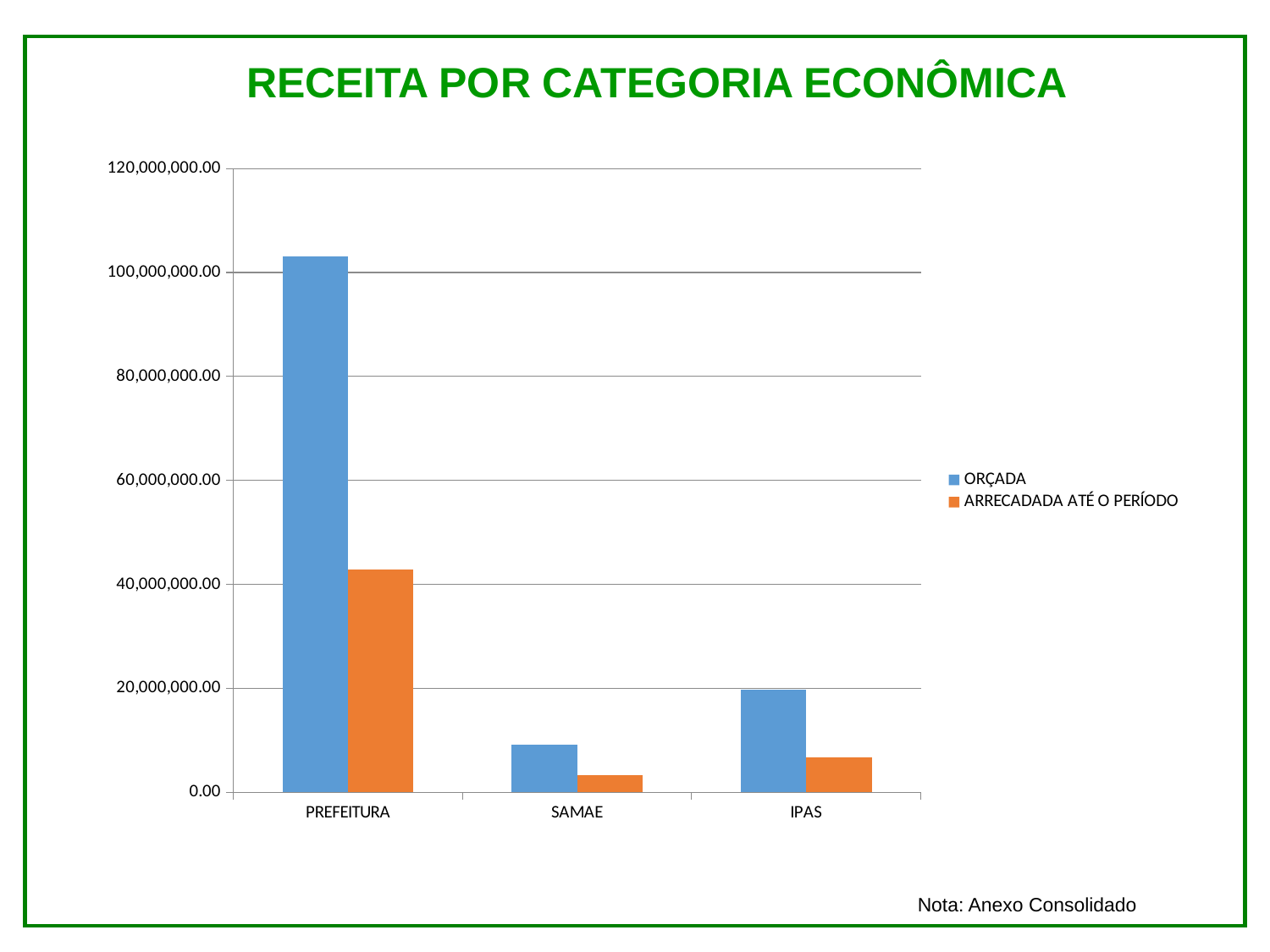
Is the ORÇADA value for PREFEITURA greater or less than 80,000,000.00? greater Which category has the lowest ARRECADADA ATÉ O PERÍODO value? SAMAE Which is larger, the ORÇADA value for IPAS or the ORÇADA value for SAMAE? IPAS Is the ARRECADADA ATÉ O PERÍODO value for PREFEITURA greater or less than 60,000,000.00? less Which category has the highest ORÇADA value? PREFEITURA What is the title of the chart? RECEITA POR CATEGORIA ECONÔMICA How many categories are shown on the x axis? 3 Which category has the lowest ORÇADA value? SAMAE How many series does the legend list? 2 Which colour represents the ARRECADADA ATÉ O PERÍODO series? orange Is the ORÇADA value for SAMAE greater or less than 20,000,000.00? less What kind of chart is shown on the slide? bar chart